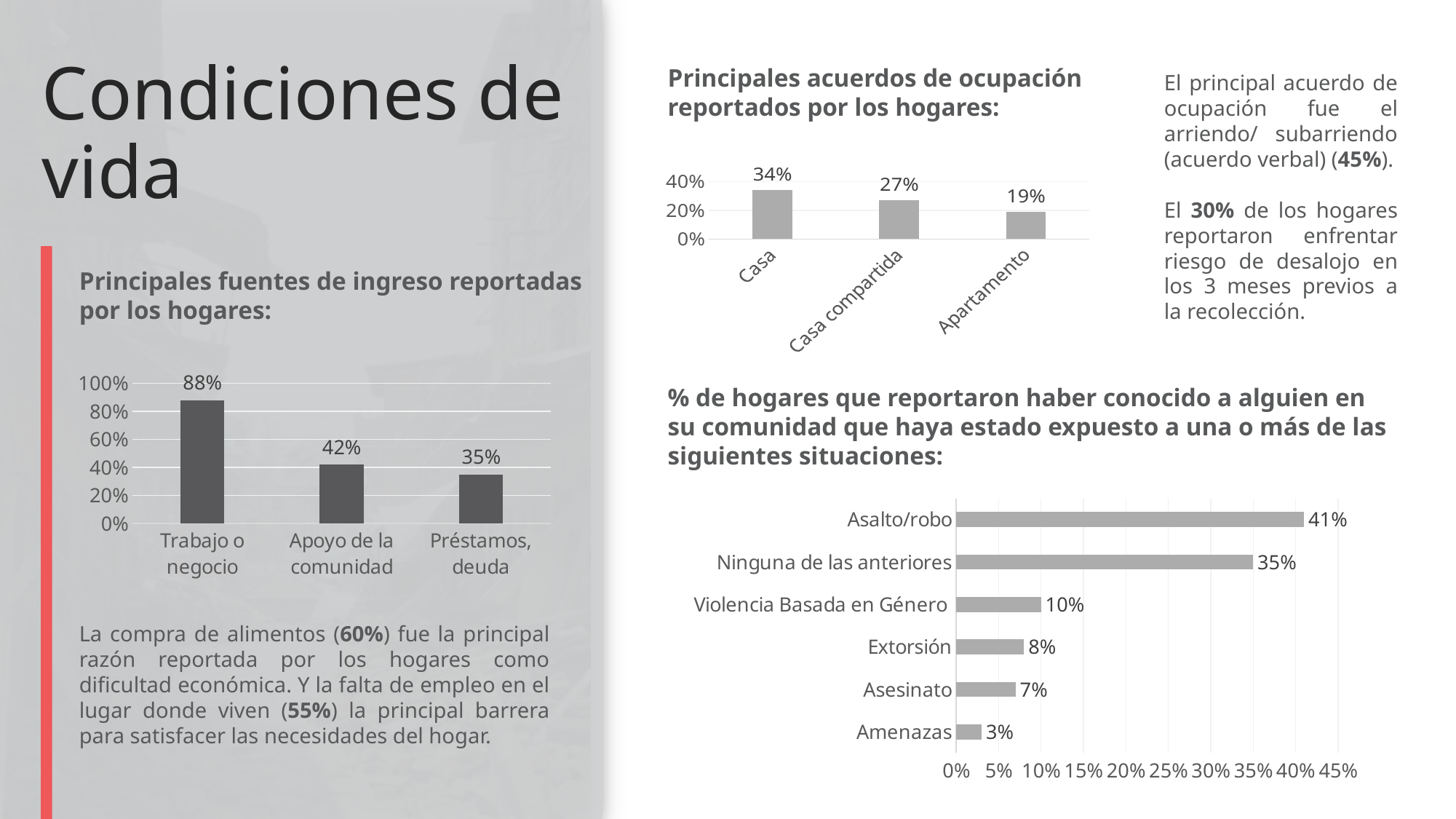
In the chart 'Principales fuentes de ingreso reportadas por los hogares', what is the value for 'Trabajo o negocio'? 88% In the chart 'Principales fuentes de ingreso reportadas por los hogares', what is the difference between 'Trabajo o negocio' and 'Apoyo de la comunidad'? 46% In the chart '% de hogares que reportaron haber conocido a alguien en su comunidad...', what is the value for 'Extorsión'? 8% What kind of chart is the chart '% de hogares que reportaron haber conocido a alguien en su comunidad...'? Bar chart How many categories are shown in the chart 'Principales fuentes de ingreso reportadas por los hogares'? 3 How many categories are shown in the chart '% de hogares que reportaron haber conocido a alguien en su comunidad...'? 6 In the chart 'Principales fuentes de ingreso reportadas por los hogares', which category has the lowest value? Préstamos, deuda In the chart '% de hogares que reportaron haber conocido a alguien en su comunidad...', which category has the lowest value? Amenazas In the chart 'Principales acuerdos de ocupación reportados por los hogares', which category has the highest value? Casa In the chart 'Principales acuerdos de ocupación reportados por los hogares', what is the value for 'Casa compartida'? 27% In the chart '% de hogares que reportaron haber conocido a alguien en su comunidad...', which is larger: 'Violencia Basada en Género' or 'Asesinato'? Violencia Basada en Género In the chart 'Principales acuerdos de ocupación reportados por los hogares', what is the difference between 'Casa' and 'Apartamento'? 15%